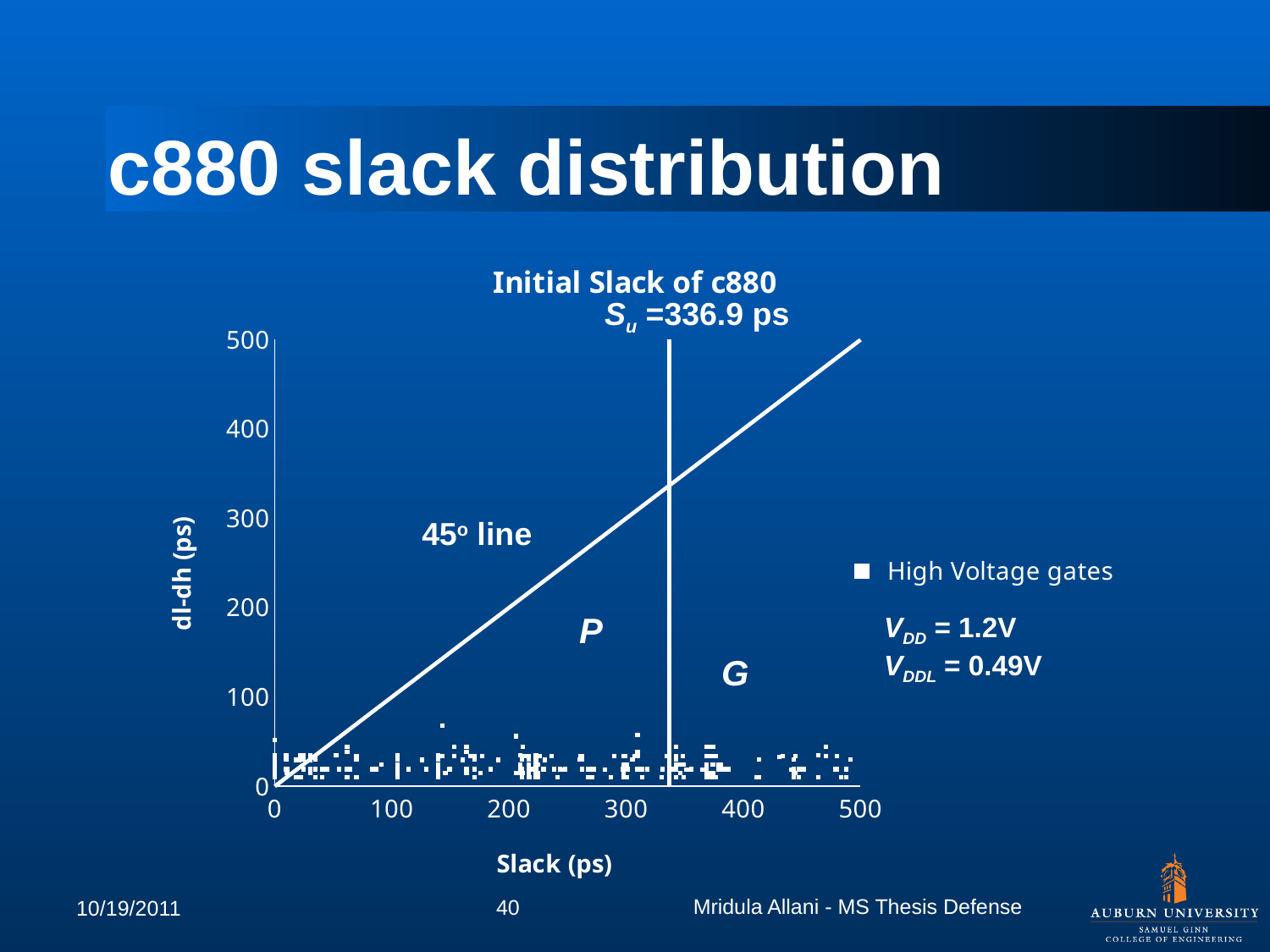
Is the Su value marked by the vertical line greater or less than 300 on the Slack axis? greater What value of VDD is stated on the chart? 1.2V What series name is shown in the chart legend? High Voltage gates What is the title of the chart? Initial Slack of c880 What value of VDDL is stated on the chart? 0.49V What is the value of Su annotated on the chart? 336.9 ps Are the plotted High Voltage gates points mostly greater or less than 100 on the dl-dh axis? less What is the label of the x axis? Slack (ps) What is the maximum tick value shown on the x axis? 500 What kind of chart is shown on the slide? scatter chart How many series does the legend list? 1 What is the label of the y axis? dl-dh (ps)